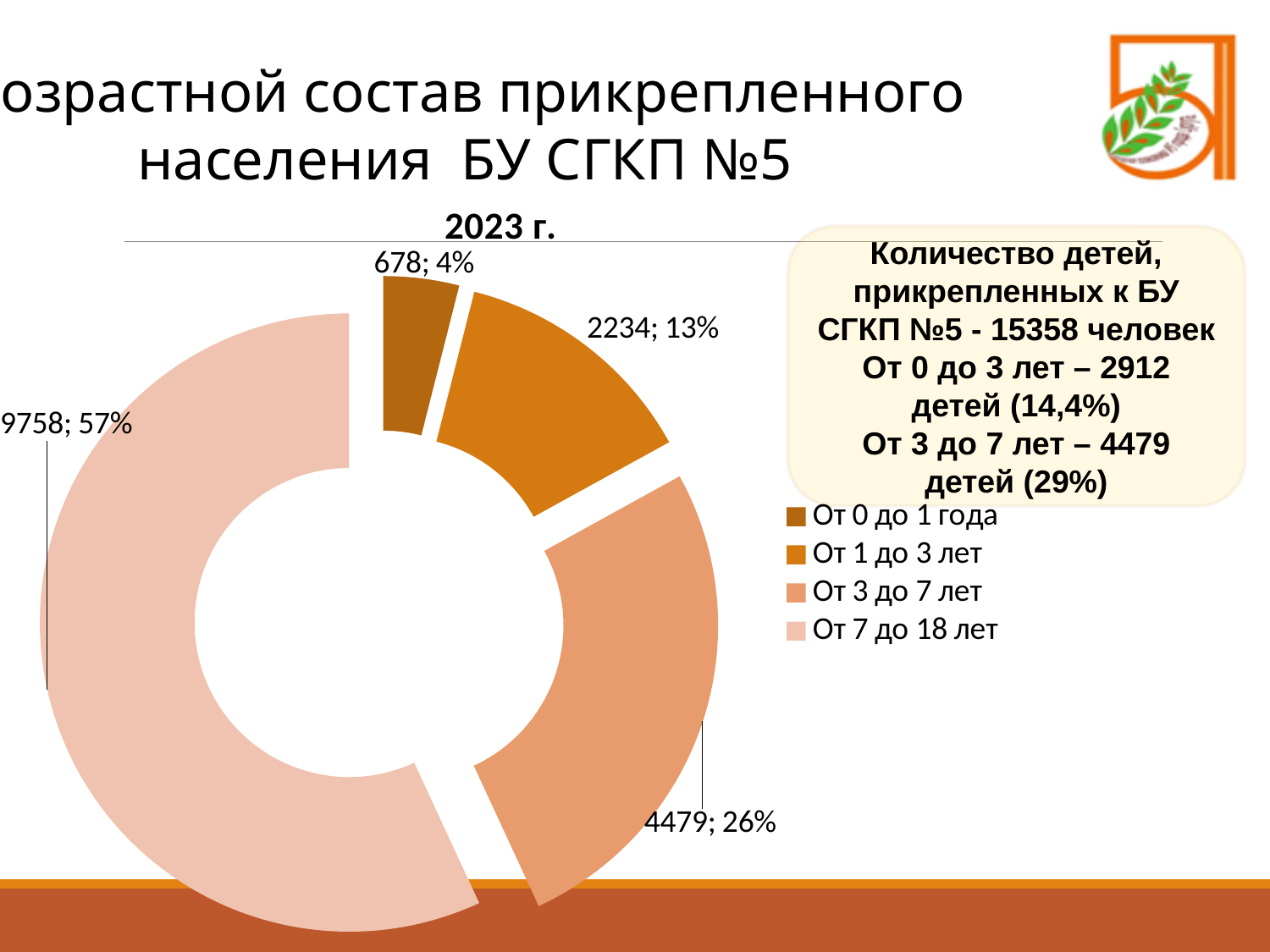
Which is larger: the value for 'От 1 до 3 лет' or the value for 'От 3 до 7 лет'? От 3 до 7 лет What is the value for the 'От 0 до 1 года' category in the chart? 678 What type of chart is shown on the slide? Doughnut (pie) chart What is the value for the 'От 7 до 18 лет' category in the chart? 9758 Which category has the largest share of the chart? От 7 до 18 лет What percentage share does the 'От 3 до 7 лет' slice have? 26% What is the difference between the values for 'От 7 до 18 лет' and 'От 3 до 7 лет'? 5279 What is the value for the 'От 1 до 3 лет' category in the chart? 2234 How many categories does the chart show? 4 What percentage share does the 'От 1 до 3 лет' slice have? 13% What is the value for the 'От 3 до 7 лет' category in the chart? 4479 Which category has the smallest share of the chart? От 0 до 1 года